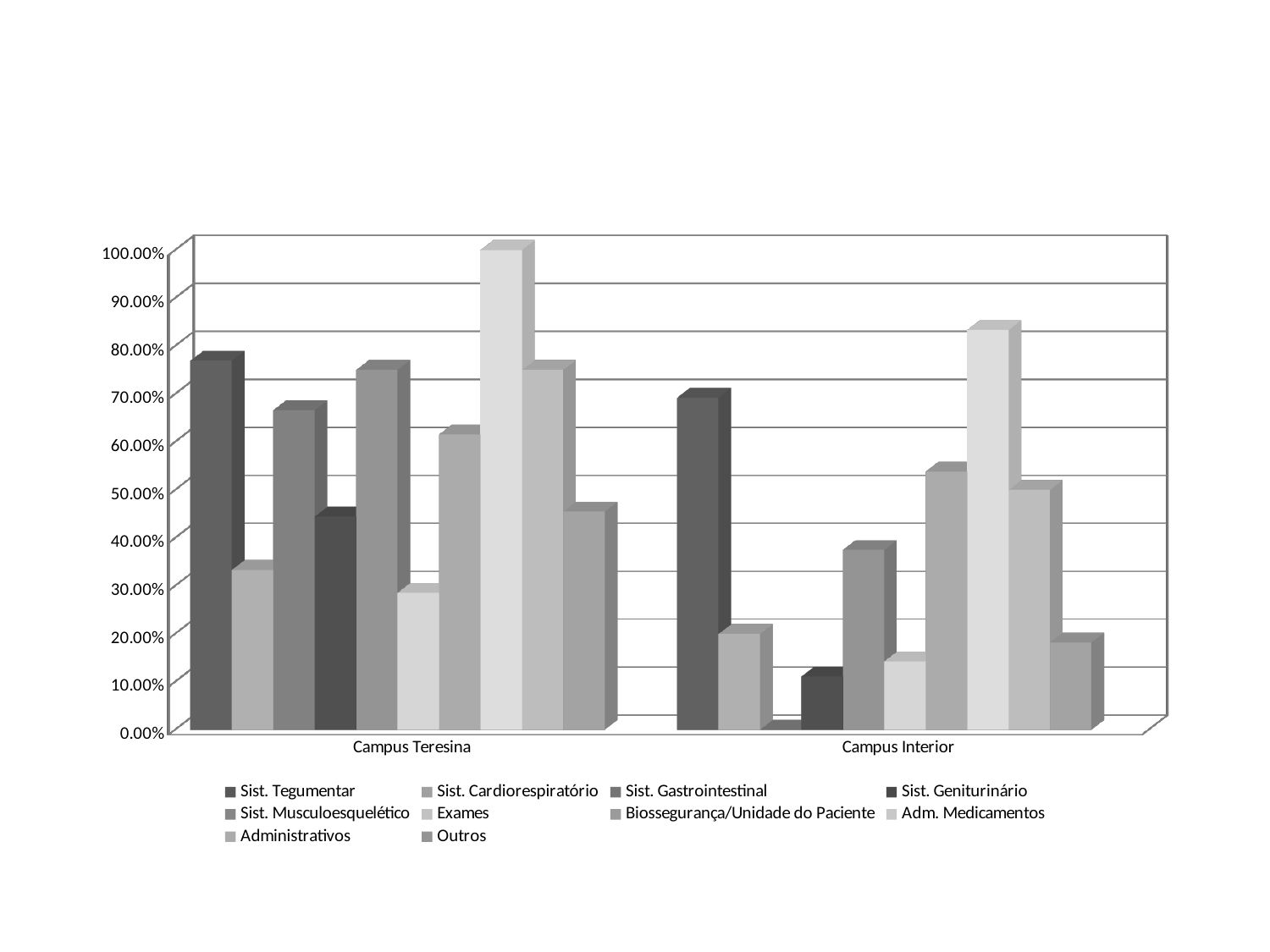
Which series has the lowest value for Campus Interior? Sist. Gastrointestinal Is the value for Sist. Tegumentar at Campus Teresina greater or less than 70.00%? greater Is the value for Sist. Cardiorespiratório at Campus Interior greater or less than 30.00%? less Which series has the highest value for Campus Interior? Adm. Medicamentos Is the value for Sist. Gastrointestinal at Campus Interior greater or less than 10.00%? less What is the highest value shown on the y axis? 100.00% How many categories are shown on the x axis? 2 Is the value of Sist. Musculoesquelético larger for Campus Teresina or Campus Interior? Campus Teresina Which series has the highest value for Campus Teresina? Adm. Medicamentos How many series does the legend list? 10 What kind of chart is shown on the slide? bar chart Is the value of Sist. Tegumentar larger for Campus Teresina or Campus Interior? Campus Teresina